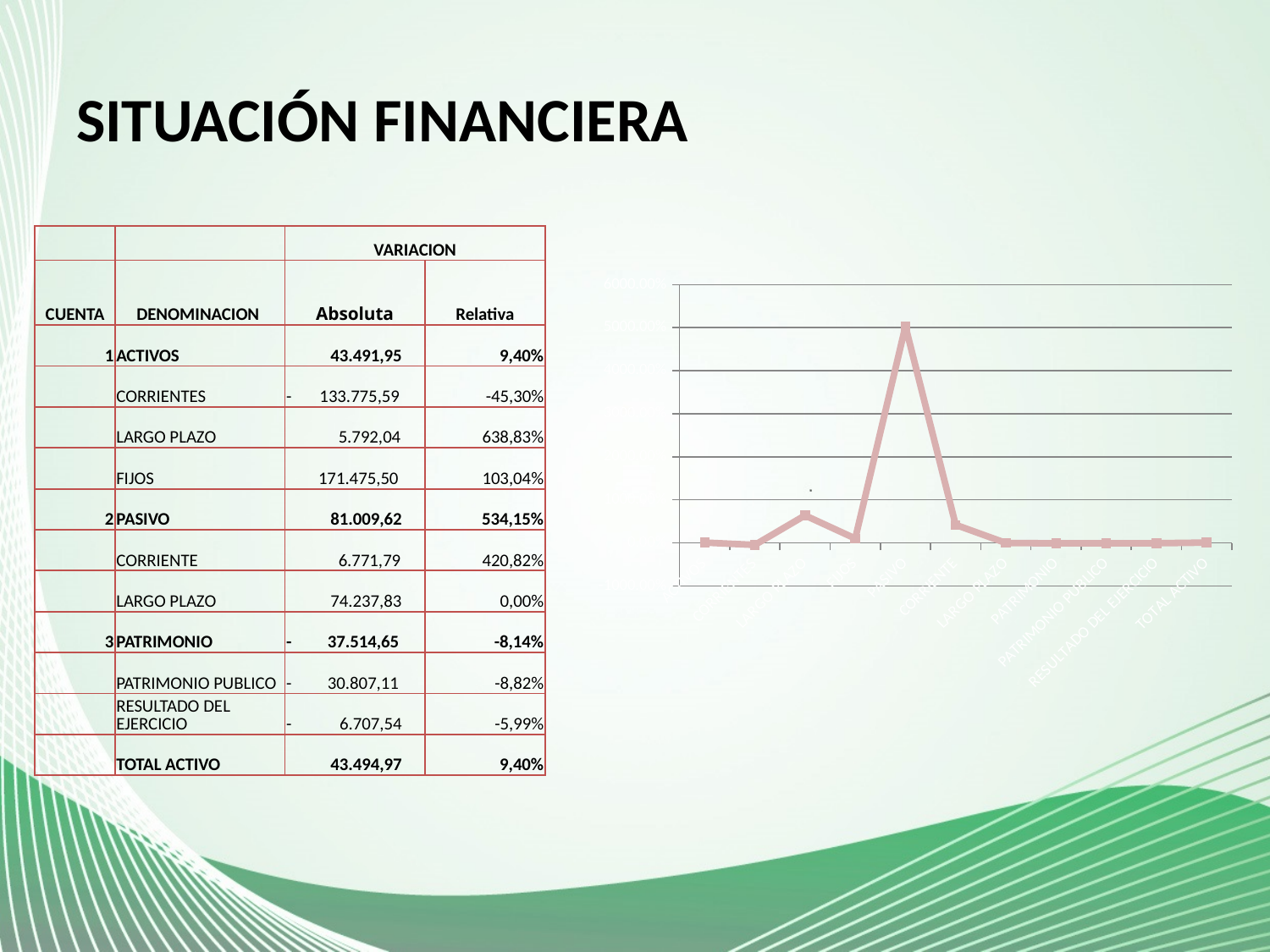
How many data points are plotted on the line chart? 11 What colour is the line in the chart? pink Counting from the left, which data point on the line chart is the highest? the fifth What kind of chart is shown on the right side of the slide? line chart How many lines (series) are plotted in the chart? 1 Does the line chart show a single sharp peak or several peaks of similar height? a single sharp peak